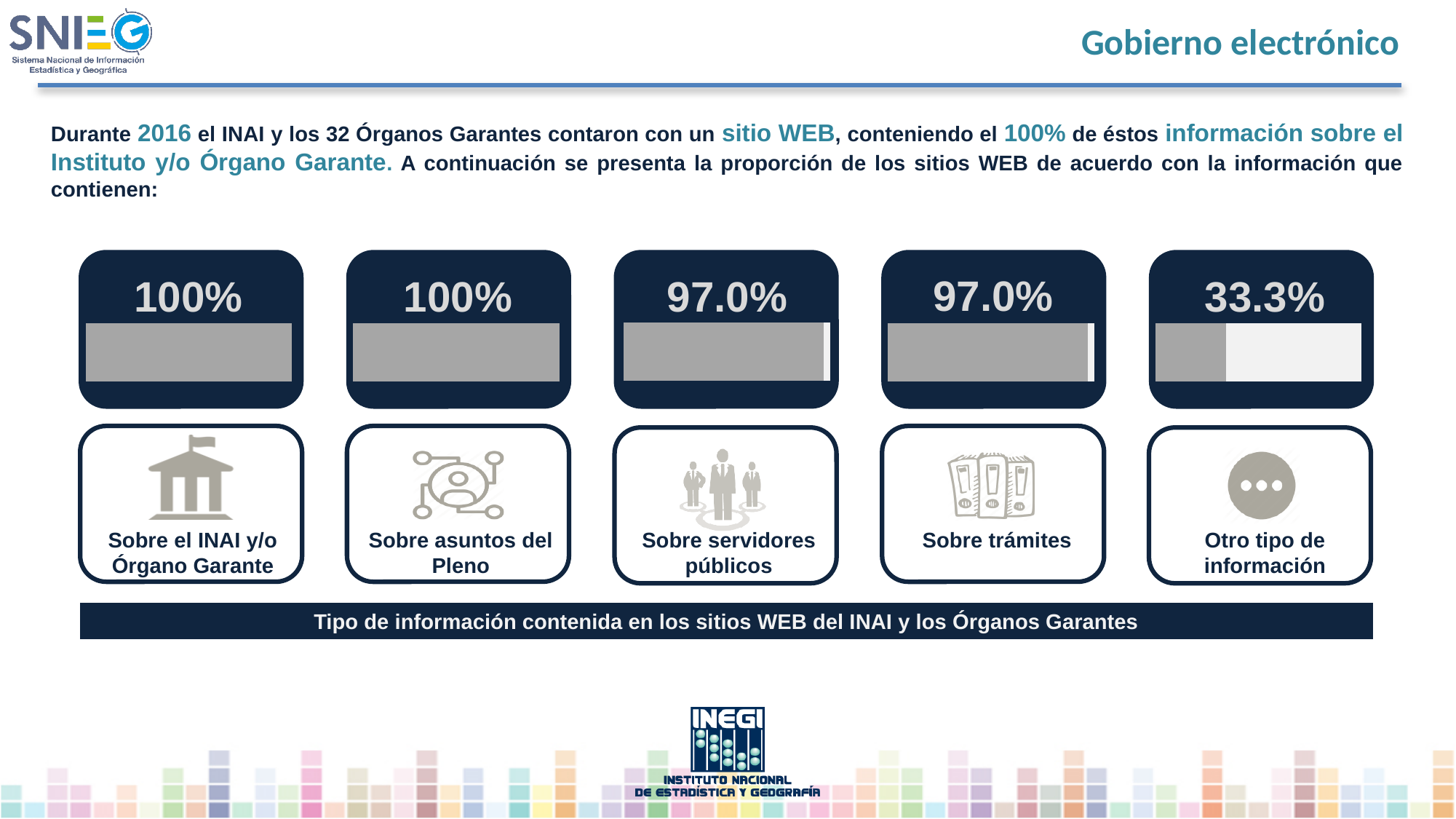
What percentage of the websites contain information 'Sobre servidores públicos'? 97.0% What is the difference between the proportion for 'Sobre asuntos del Pleno' and 'Sobre servidores públicos'? 3 percentage points What percentage of the websites contain information 'Sobre trámites'? 97.0% What percentage of the websites contain information 'Sobre el INAI y/o Órgano Garante'? 100% What percentage of the websites contain 'Otro tipo de información'? 33.3% Which is larger: the proportion for 'Sobre servidores públicos' or for 'Otro tipo de información'? Sobre servidores públicos What is the title of the chart? Tipo de información contenida en los sitios WEB del INAI y los Órganos Garantes Which type of information has the lowest proportion of websites? Otro tipo de información What percentage of the websites contain information 'Sobre asuntos del Pleno'? 100% How many types of information are shown in the chart? 5 What kind of chart is used to show the proportions? Bar chart What is the difference between the proportion for 'Sobre trámites' and 'Otro tipo de información'? 63.7 percentage points